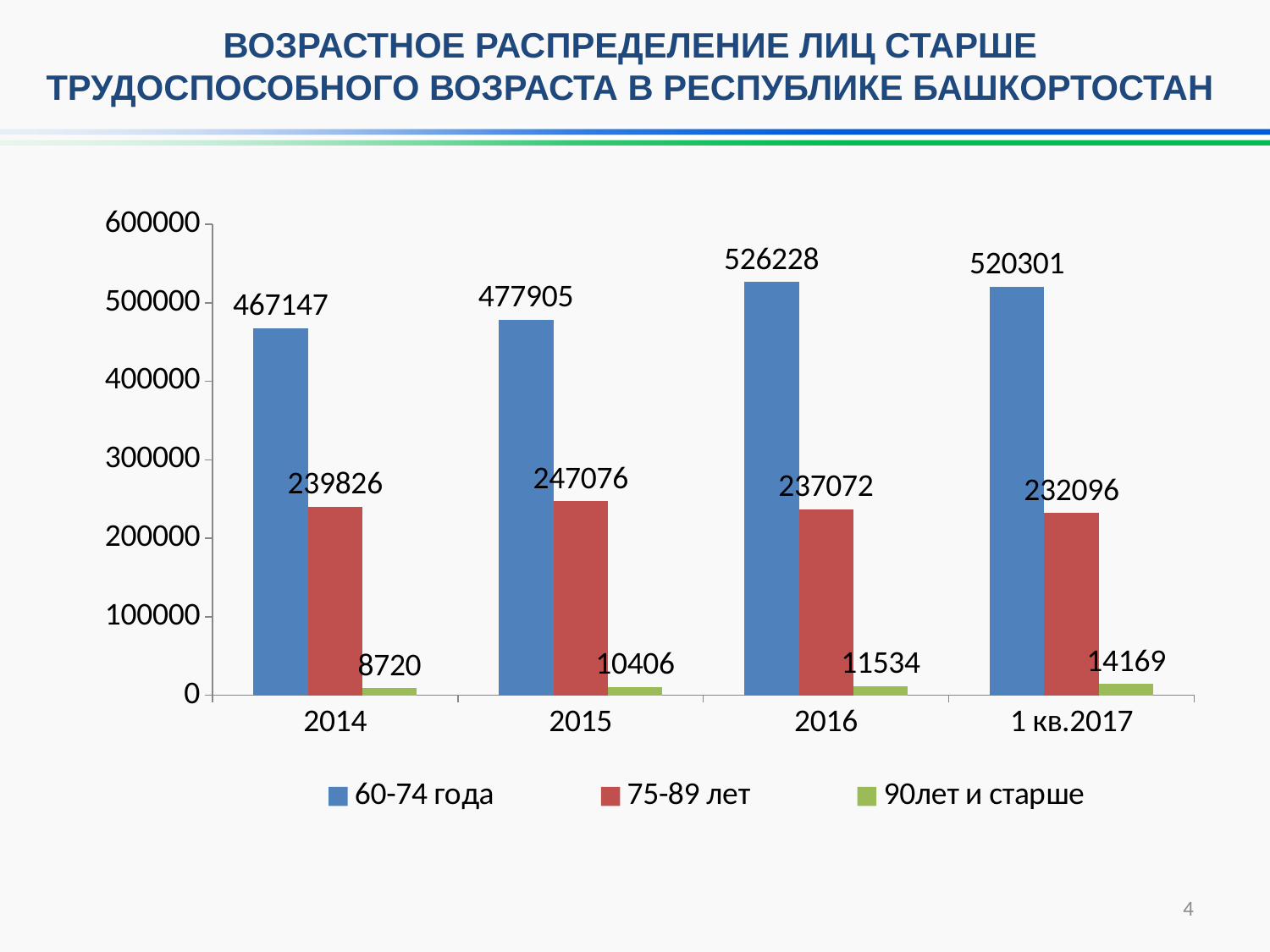
Do the values for the 90лет и старше series rise or fall from 2014 to 1 кв.2017? rise What is the difference between the 75-89 лет values for 2015 and 2014? 7250 Which is larger: the 75-89 лет value in 2015 or in 2016? 2015 How many series does the legend list? 3 What is the difference between the 60-74 года values for 2016 and 1 кв.2017? 5927 In which period is the 60-74 года series highest? 2016 What is the value for the 90лет и старше series in 1 кв.2017? 14169 What is the value for the 75-89 лет series in 2014? 239826 In which period is the 90лет и старше series lowest? 2014 Is the 60-74 года value for 2014 greater or less than 500000? less What is the value for the 60-74 года series in 2016? 526228 How many periods are shown on the x axis? 4